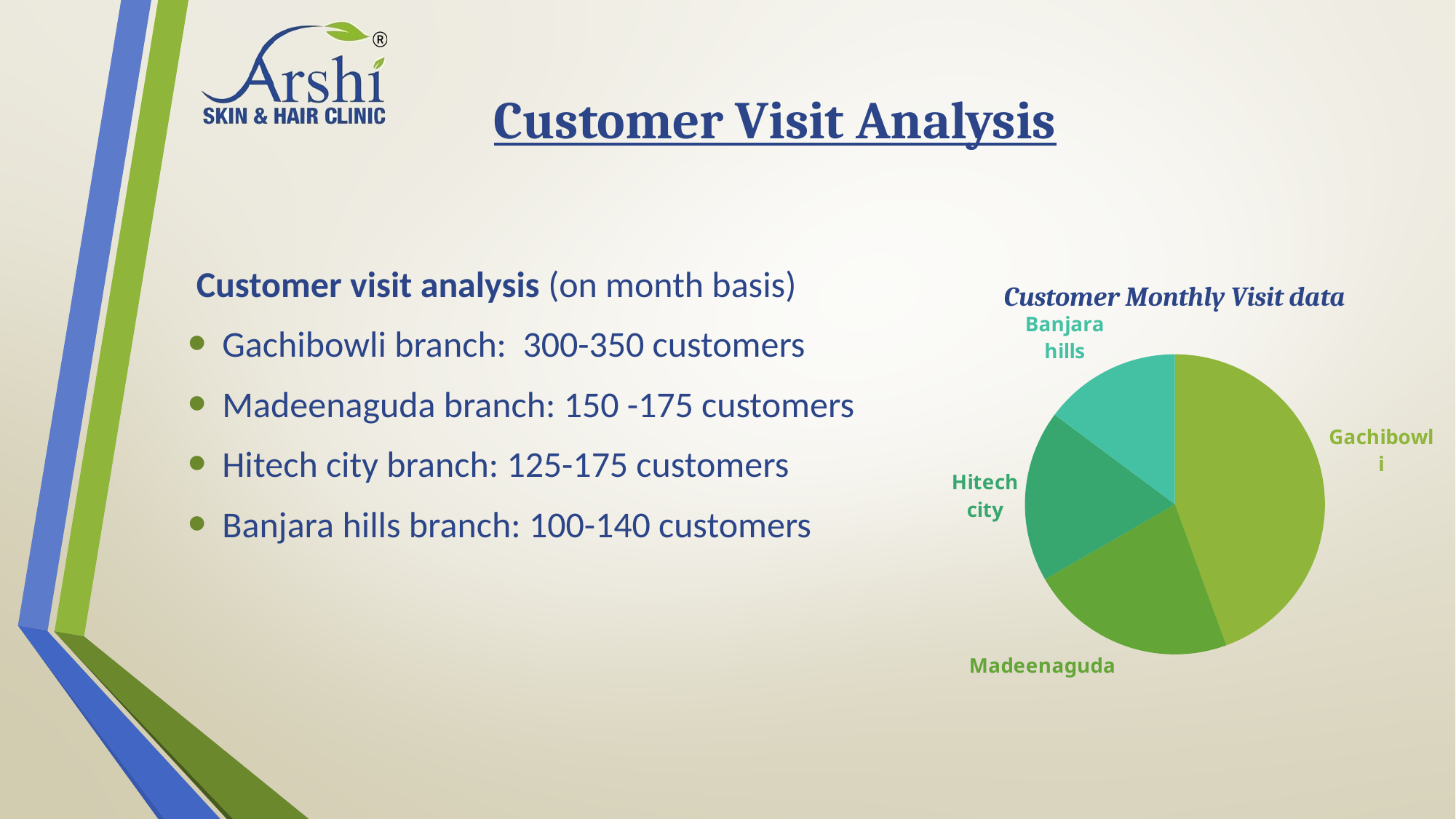
What kind of chart is shown under the title "Customer Monthly Visit data"? pie chart In the pie chart, which slice is larger: Gachibowli or Madeenaguda? Gachibowli In the pie chart, which slice is larger: Madeenaguda or Banjara hills? Madeenaguda What is the title of the pie chart on the slide? Customer Monthly Visit data Which slice of the pie chart is labelled on the right-hand side of the pie? Gachibowli In the pie chart, which slice is larger: Banjara hills or Gachibowli? Gachibowli Which branch has the largest slice in the "Customer Monthly Visit data" pie chart? Gachibowli How many slices does the "Customer Monthly Visit data" pie chart have? 4 Which branch has the smallest slice in the "Customer Monthly Visit data" pie chart? Banjara hills